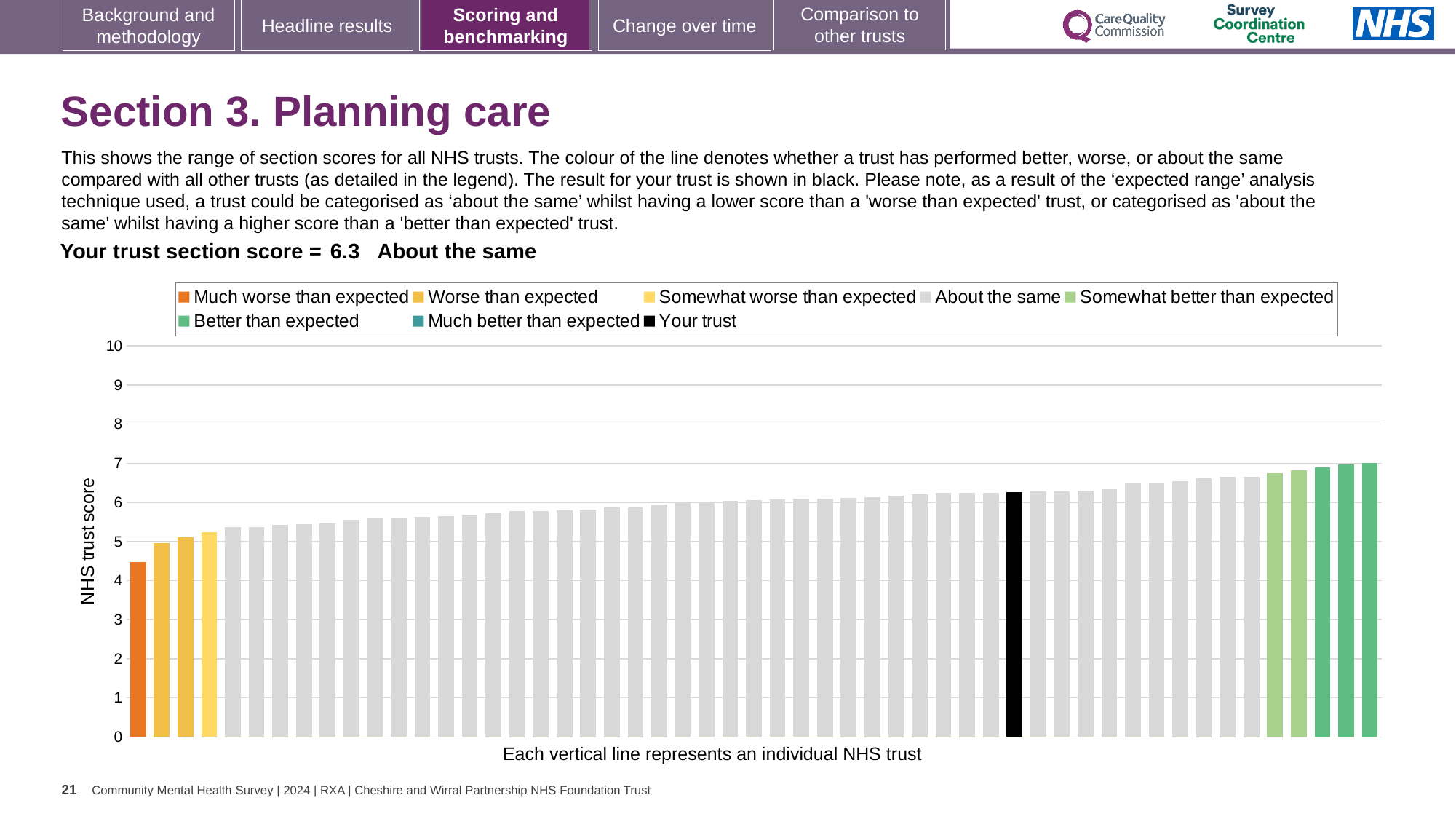
Do the bar values rise or fall moving from left to right along the x axis? rise What is the label on the vertical axis of the chart? NHS trust score Which bar is higher, the 'Your trust' bar or the 'Much worse than expected' bar? Your trust How many bars are coloured as 'Much worse than expected' (orange)? 1 How many bars are coloured as 'Better than expected' (dark green)? 3 What is the section score for your trust shown on the slide? 6.3 Is the value for the 'Much worse than expected' trust (the orange bar) greater or less than 5? less Is the value for your trust (the black bar) greater or less than 5? greater How many entries does the chart legend list? 8 What kind of chart is shown on the slide? bar chart Is the value for the highest-scoring trust (the rightmost bar) greater or less than 6? greater Which category is your trust's section score placed in? About the same